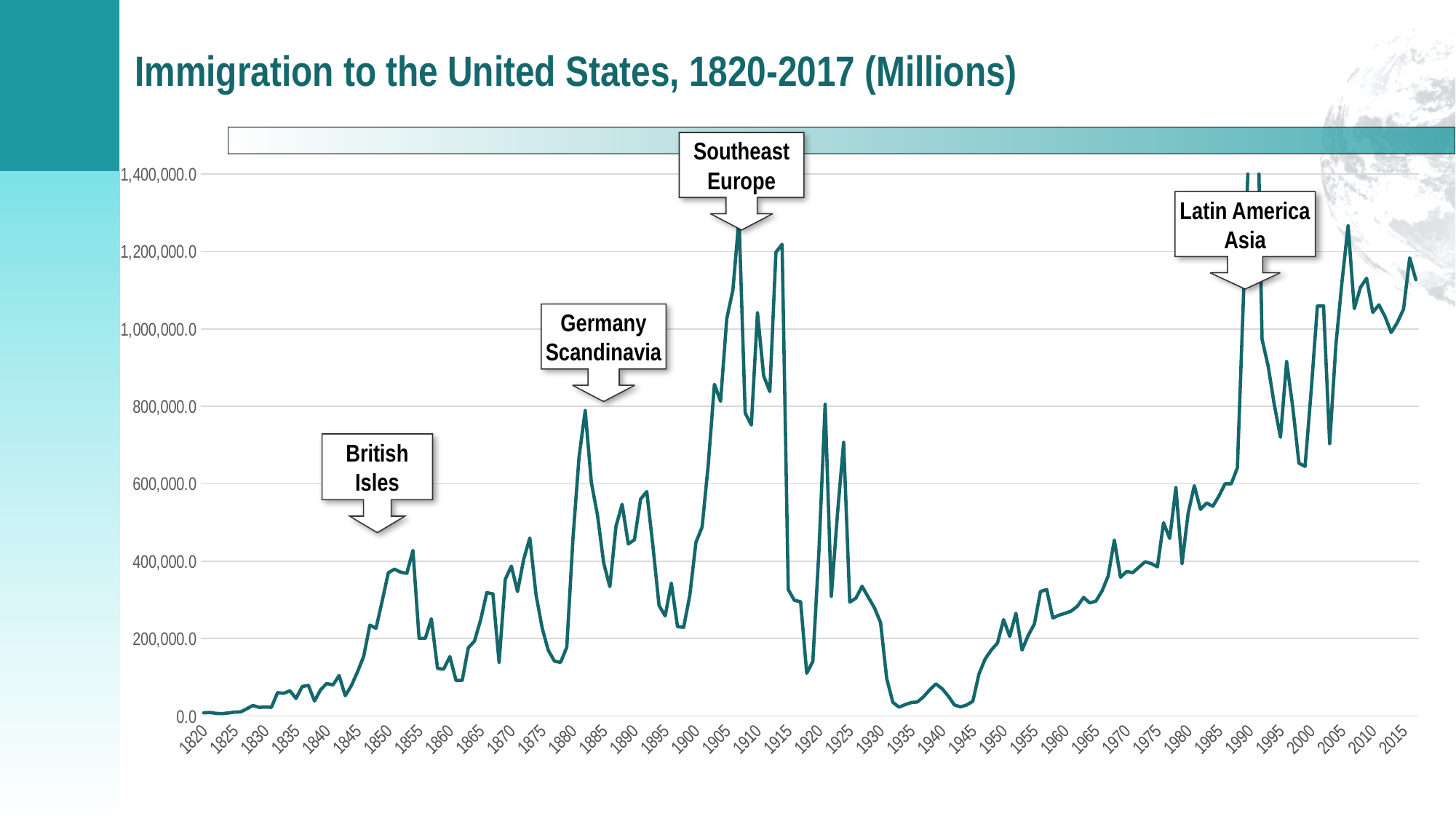
Is the peak value around 1907 greater or less than 1,200,000? greater Is the peak value around 2006 greater or less than 1,000,000? greater Which is larger, the peak around 1907 or the peak around 1882? the peak around 1907 Is the peak value around 1882 greater or less than 600,000? greater Which is larger, the value for 1935 or the value for 1960? 1960 Do the values rise or fall between 1930 and 1935? fall What is the title of the chart? Immigration to the United States, 1820-2017 (Millions) Do the values generally rise or fall between 1945 and 1990? rise How many labelled callout boxes (annotations) point to the line on the chart? 4 What kind of chart is shown on the slide? line chart